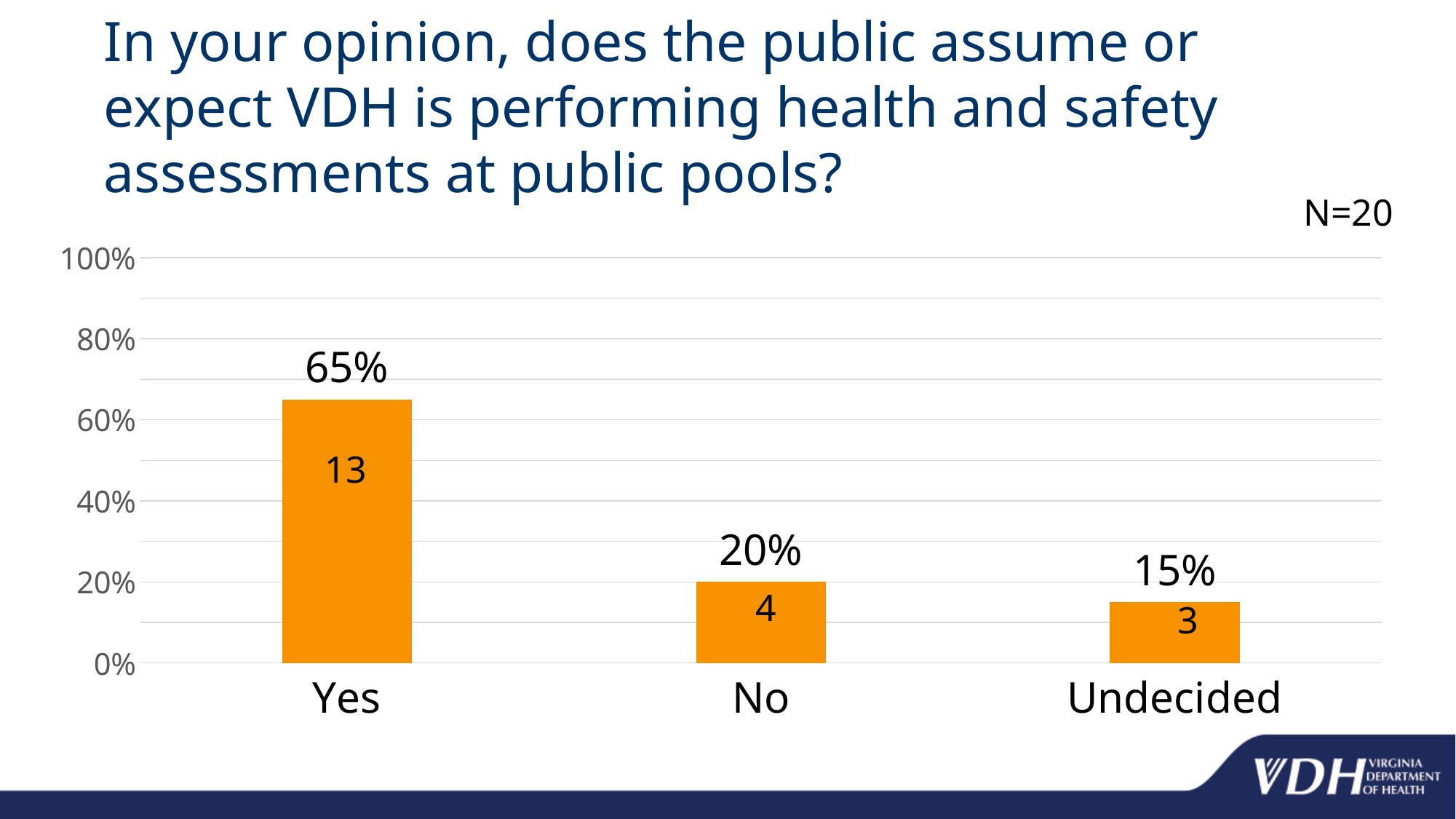
Which response category has the highest percentage? Yes What percentage of respondents were Undecided? 15% Is the value for Yes greater or less than 60%? greater How many respondents answered No? 4 What is the sample size (N) shown on the slide? N=20 Which response category has the lowest percentage? Undecided What kind of chart is shown on the slide? Bar chart Which is larger, the percentage for No or for Undecided? No How many response categories are shown on the chart? 3 What is the difference in percentage points between Yes and No? 45% How many respondents answered Yes? 13 What percentage of respondents answered Yes? 65%